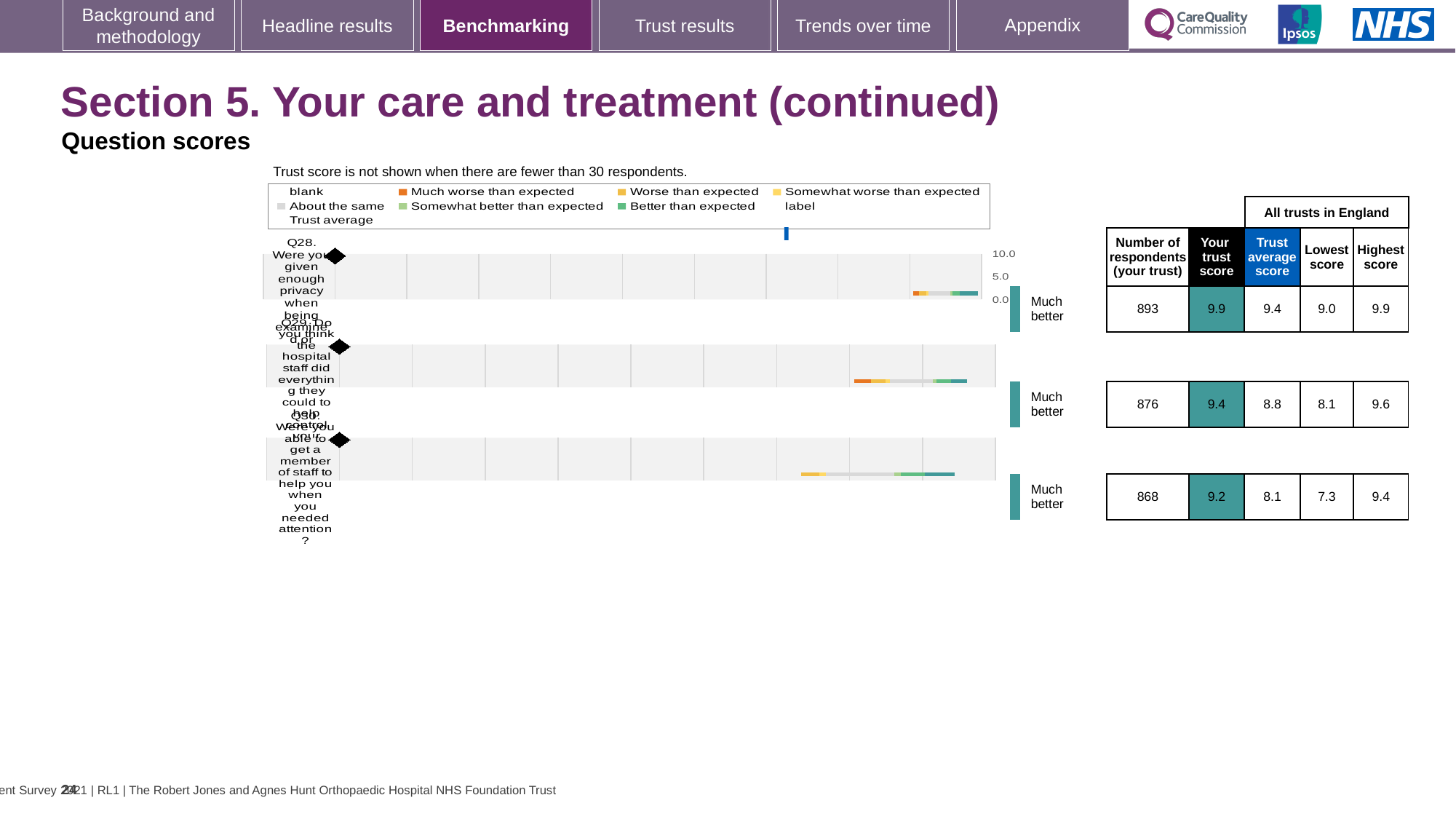
How many respondents answered Q28? 893 Which question has the fewest respondents? Q30 What is the trust score for Q28 (Were you given enough privacy when being examined or treated?)? 9.9 For Q30, what is the difference between the trust score and the trust average score? 1.1 Which has the larger trust score, Q29 or Q30? Q29 Which question has the highest trust score on this slide? Q28 How many questions are charted on this slide? 3 What benchmark category label is shown next to the Q28 chart? Much better What is the lowest score across all trusts in England for Q30 (Were you able to get a member of staff to help you when you needed attention?)? 7.3 What kind of chart is used to show the question scores? Bar chart What is the highest score across all trusts in England for Q29? 9.6 What is the trust average score for Q29 (Do you think the hospital staff did everything they could to help control your pain?)? 8.8